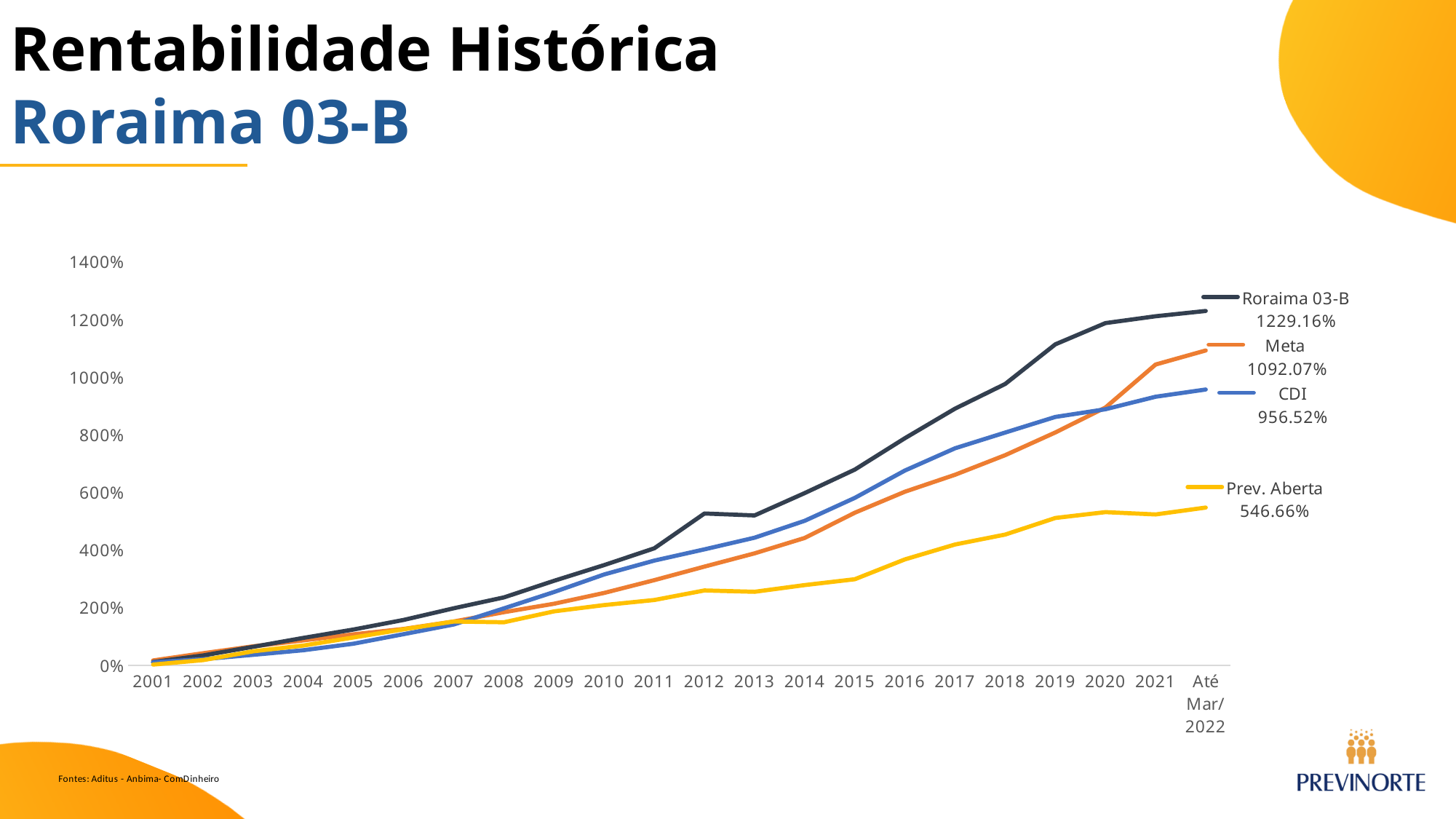
At the end of the chart, which is larger: the Meta value or the CDI value? Meta What kind of chart is shown on the slide? Line chart How many series does the chart legend list? 4 What is the final value shown for the CDI series? 956.52% What is the final value shown for the Roraima 03-B series? 1229.16% Is the value for Prev. Aberta in 2019 greater or less than 600%? less What is the final value shown for the Prev. Aberta series? 546.66% What is the difference between the final values of Roraima 03-B and Meta? 137.09% Which series has the highest value at the end of the chart (Até Mar/2022)? Roraima 03-B Is the value for Roraima 03-B in 2012 greater or less than 400%? greater What is the final value shown for the Meta series? 1092.07% Which series has the lowest value at the end of the chart (Até Mar/2022)? Prev. Aberta